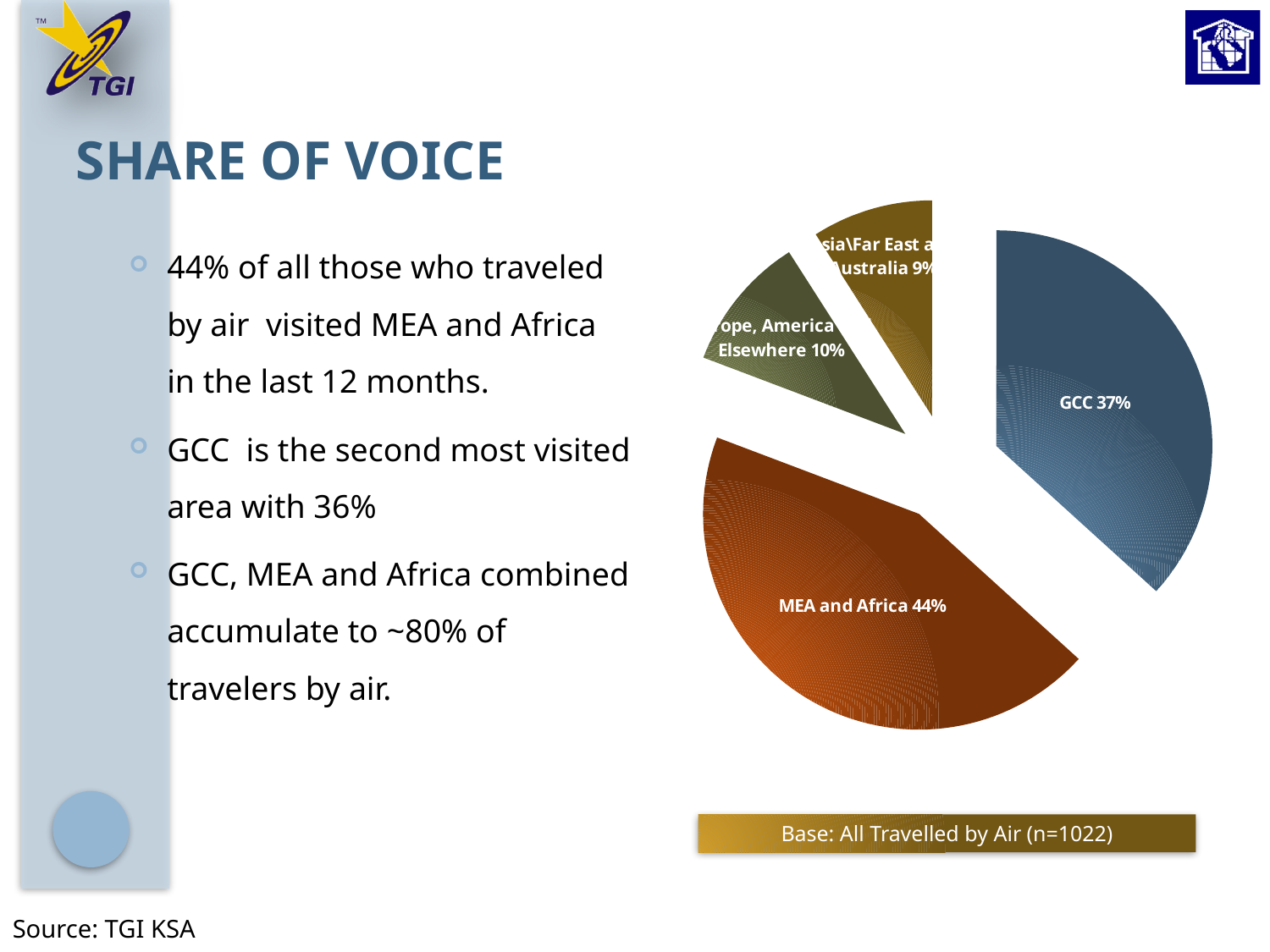
Which slice of the pie is the largest? MEA and Africa By how many percentage points does MEA and Africa exceed GCC? 7 percentage points How many slices does the pie chart have? 4 What base is stated below the pie chart? All Travelled by Air (n=1022) What share of the pie does GCC account for? 37% Which is larger, the GCC slice or the MEA and Africa slice? MEA and Africa What source is cited at the bottom of the slide? TGI KSA What is the combined share of the GCC and MEA and Africa slices? 81% What type of chart is shown on the slide? pie chart What is the value of the smallest slice of the pie? 9% What share of the pie does MEA and Africa account for? 44% Is the MEA and Africa slice more or less than half of the pie? less